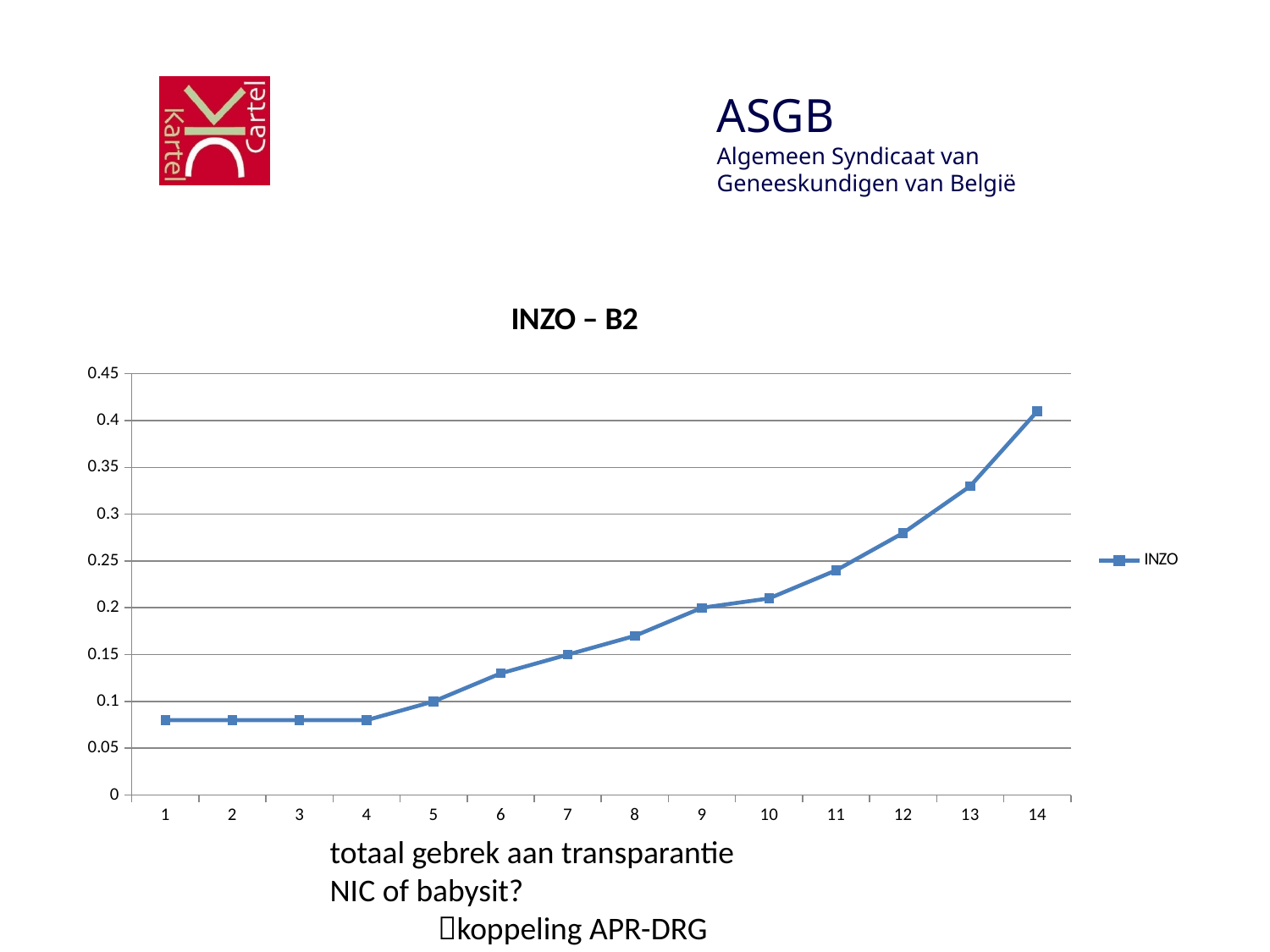
Is the INZO value for category 1 greater or less than 0.1? less What is the INZO value at category 9? 0.2 Which category has the highest INZO value? 14 What is the INZO value at category 7? 0.15 Is the INZO value for category 12 greater or less than 0.25? greater How many series does the legend list? 1 How many points are plotted along the x axis? 14 Do the INZO values rise or fall from category 1 to category 14? rise What is the title of the chart? INZO – B2 What kind of chart is shown on the slide? line chart What is the INZO value at category 5? 0.1